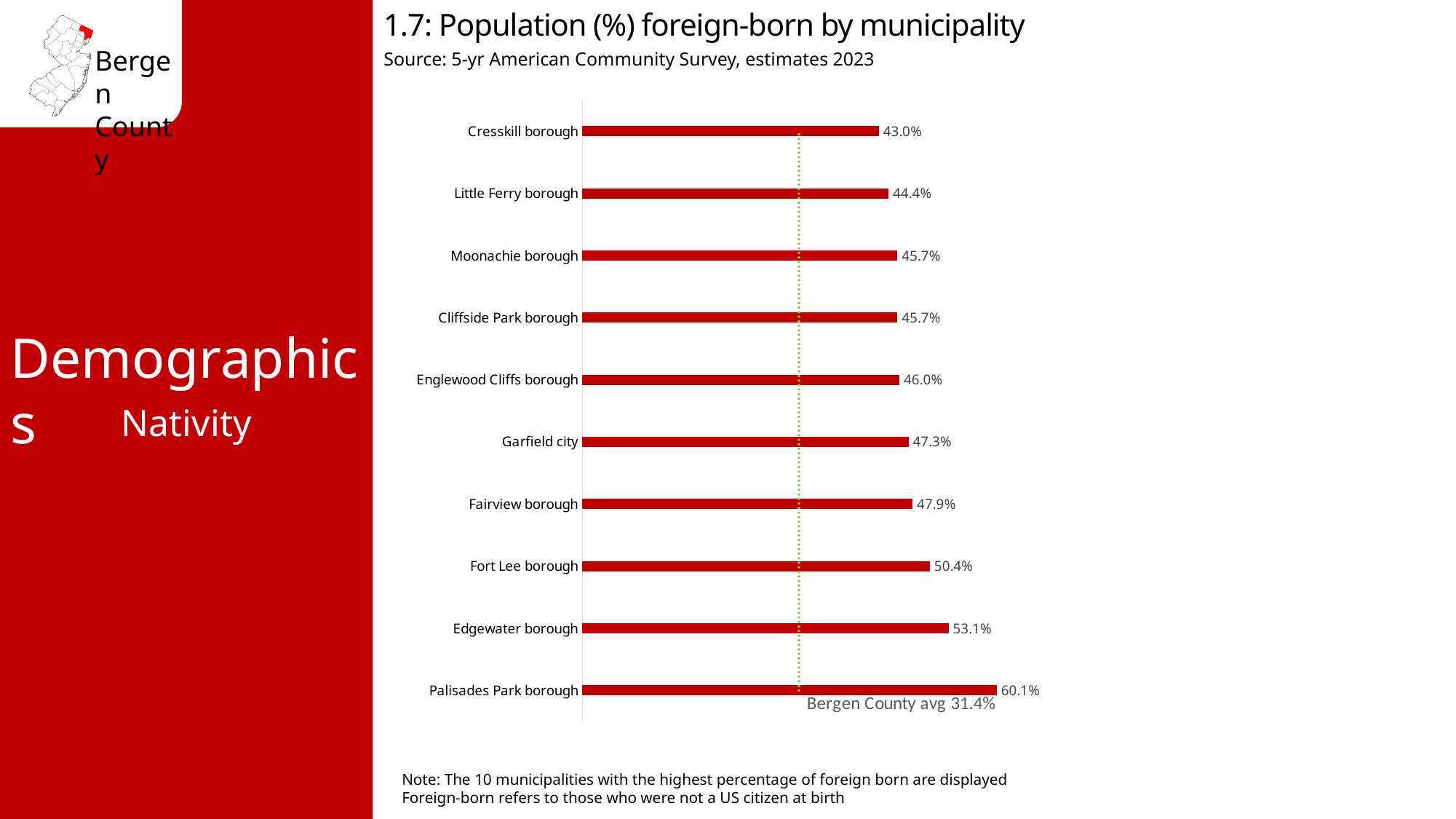
What is the difference in foreign-born percentage between Fort Lee borough and Fairview borough? 2.5% What is the Bergen County average foreign-born percentage marked by the dotted line? 31.4% Which municipality has the lowest percentage of foreign-born population among those shown? Cresskill borough What is the percentage of foreign-born population for Cresskill borough? 43.0% Which municipality has the highest percentage of foreign-born population? Palisades Park borough What kind of chart is used to show the foreign-born population by municipality? Bar chart What is the percentage of foreign-born population for Fort Lee borough? 50.4% Which has a higher foreign-born percentage, Garfield city or Little Ferry borough? Garfield city What is the title of the chart? 1.7: Population (%) foreign-born by municipality What is the difference in foreign-born percentage between Palisades Park borough and Edgewater borough? 7.0% How many municipalities are shown in the chart? 10 What is the percentage of foreign-born population for Palisades Park borough? 60.1%